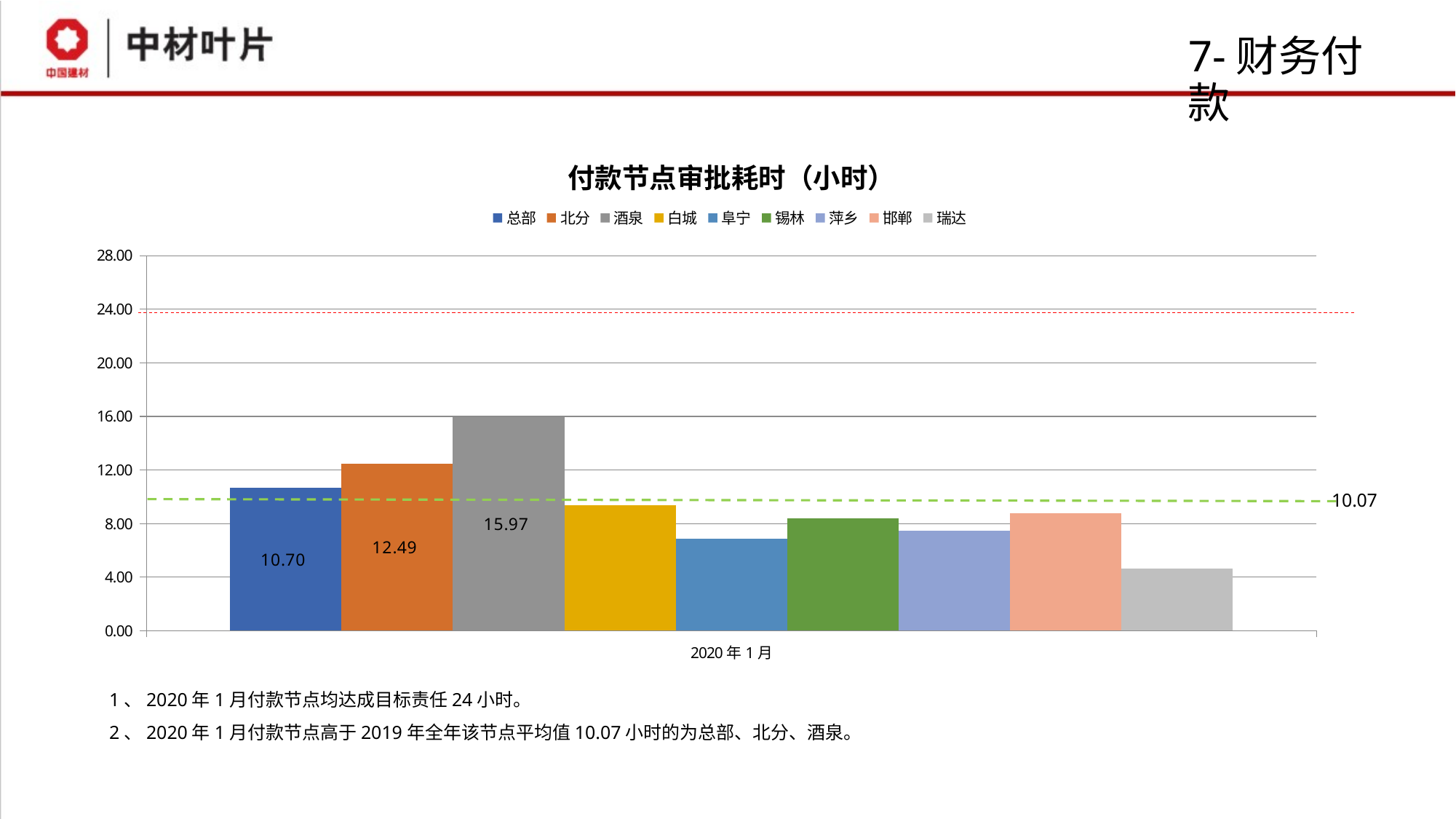
Which is larger, the value for 白城 or the value for 阜宁? 白城 What is the value for 北分 in the chart? 12.49 Is the value for 锡林 greater or less than 12.00? less Is the value for 瑞达 greater or less than 8.00? less What is the difference between the values for 酒泉 and 总部? 5.27 What is the value for 总部 in the chart? 10.70 How many series does the legend list? 9 Which series has the lowest value in the chart? 瑞达 What is the value for 酒泉 in the chart? 15.97 What is the difference between the values for 北分 and 总部? 1.79 Which series has the highest value in the chart? 酒泉 What kind of chart is shown on the slide? bar chart